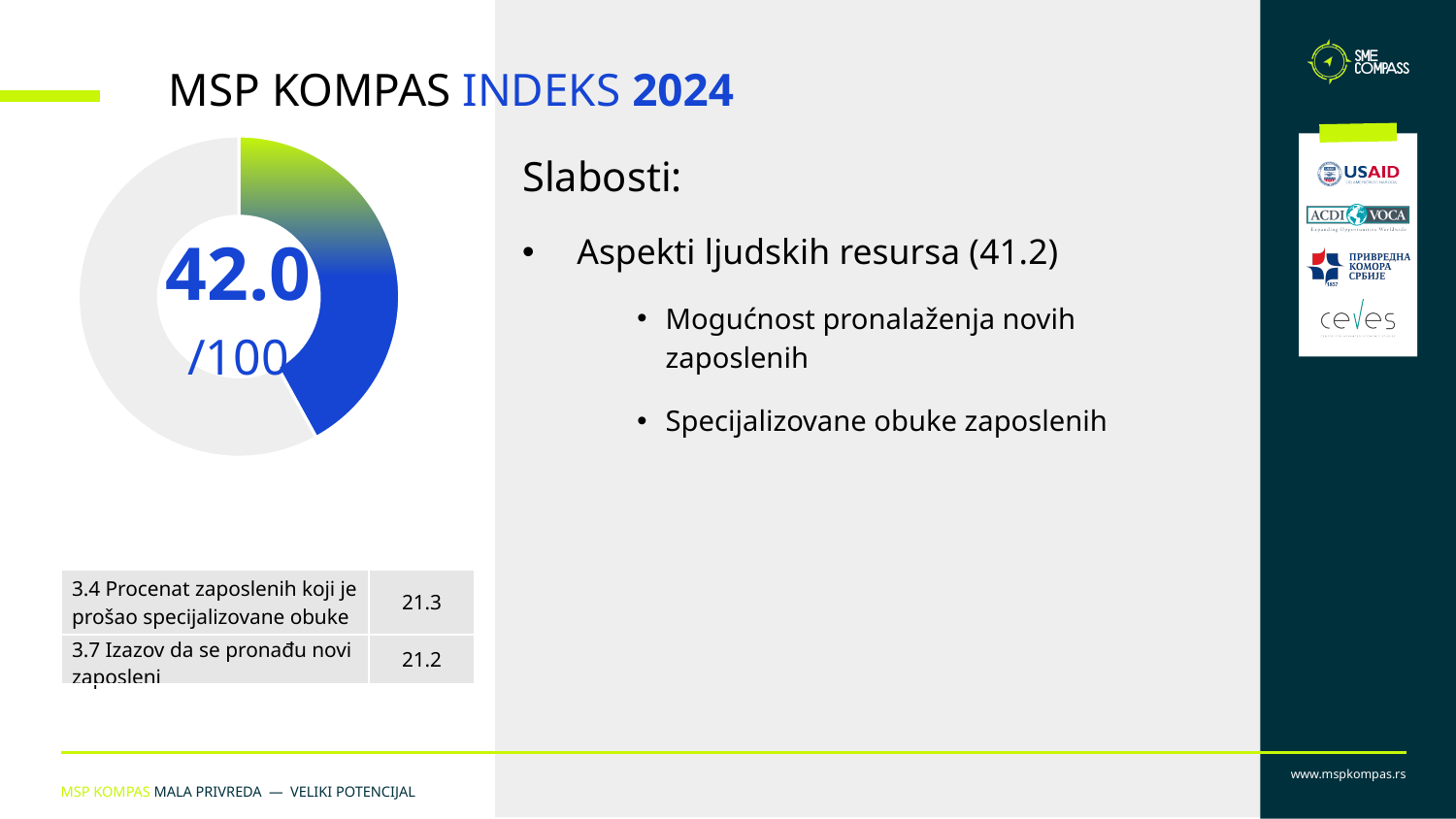
What kind of chart is shown on the left of the slide? Donut chart Is the value shown in the donut chart greater or less than 50? less Is the coloured portion of the donut chart larger or smaller than the grey portion? smaller What is the title of the slide containing the donut chart? MSP KOMPAS INDEKS 2024 Out of what maximum is the donut chart's value expressed? 100 What share of the donut chart is filled by the coloured segment? 42.0% What is the difference between the maximum of 100 and the value shown in the donut chart? 58.0 What value is displayed in the centre of the donut chart? 42.0 What colour is the unfilled remainder of the donut chart? Grey